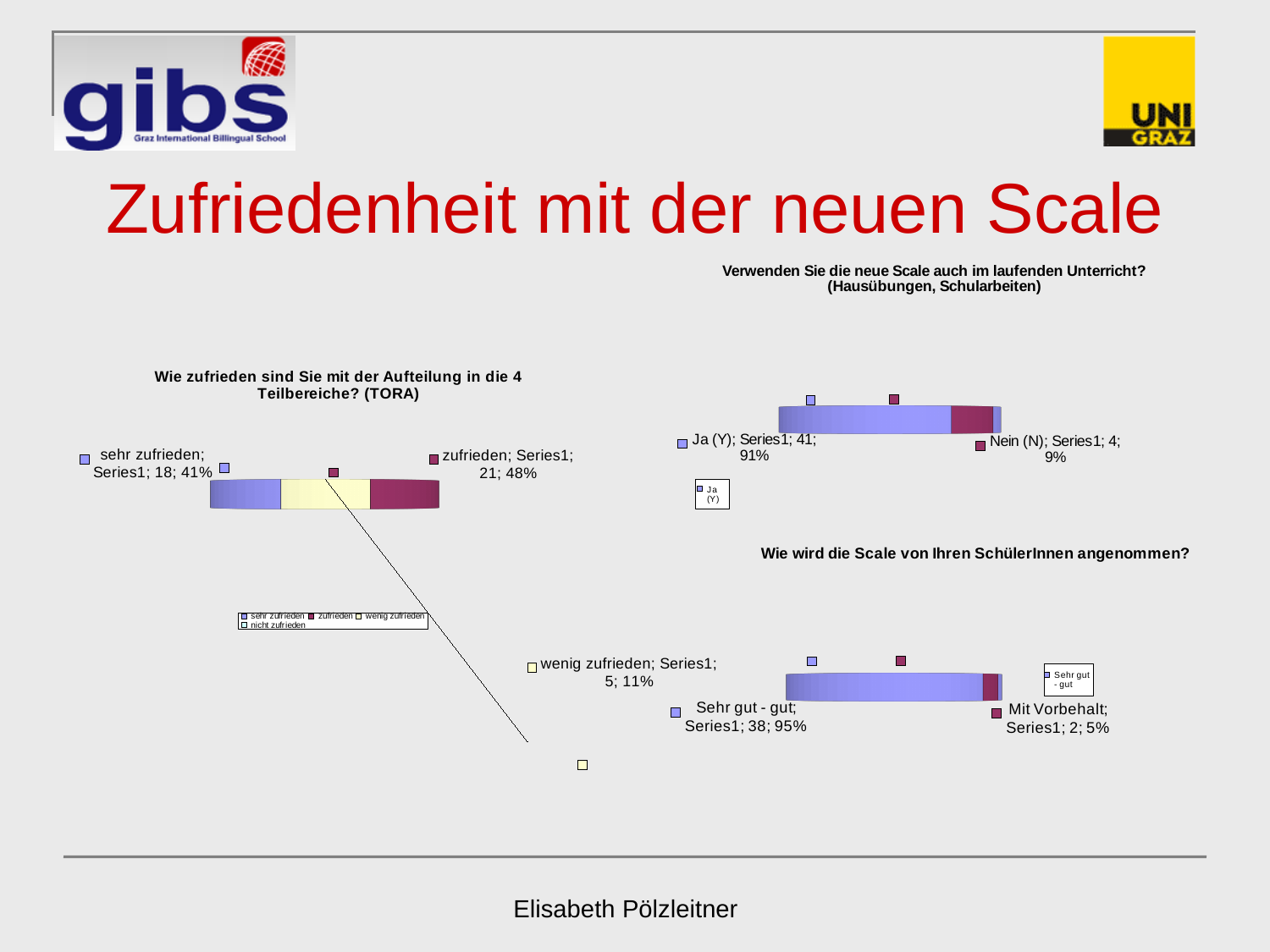
In the chart titled "Wie wird die Scale von Ihren SchülerInnen angenommen?", which is larger, "Sehr gut - gut" or "Mit Vorbehalt"? Sehr gut - gut In the chart titled "Wie zufrieden sind Sie mit der Aufteilung in die 4 Teilbereiche? (TORA)", which category has the highest value? zufrieden In the chart titled "Verwenden Sie die neue Scale auch im laufenden Unterricht?", what percentage share does "Nein (N)" have? 9% In the chart titled "Verwenden Sie die neue Scale auch im laufenden Unterricht?", what is the value for "Ja (Y)"? 41 In the chart titled "Wie zufrieden sind Sie mit der Aufteilung in die 4 Teilbereiche? (TORA)", how many entries does the legend list? 4 In the chart titled "Wie zufrieden sind Sie mit der Aufteilung in die 4 Teilbereiche? (TORA)", what is the difference between the values for "zufrieden" and "sehr zufrieden"? 3 In the chart titled "Verwenden Sie die neue Scale auch im laufenden Unterricht?", what is the difference between the values for "Ja (Y)" and "Nein (N)"? 37 In the chart titled "Wie zufrieden sind Sie mit der Aufteilung in die 4 Teilbereiche? (TORA)", what percentage share does "sehr zufrieden" have? 41% In the chart titled "Wie zufrieden sind Sie mit der Aufteilung in die 4 Teilbereiche? (TORA)", what is the value for "zufrieden"? 21 What kind of chart is the chart titled "Wie wird die Scale von Ihren SchülerInnen angenommen?"? pie chart In the chart titled "Wie wird die Scale von Ihren SchülerInnen angenommen?", what is the value for "Mit Vorbehalt"? 2